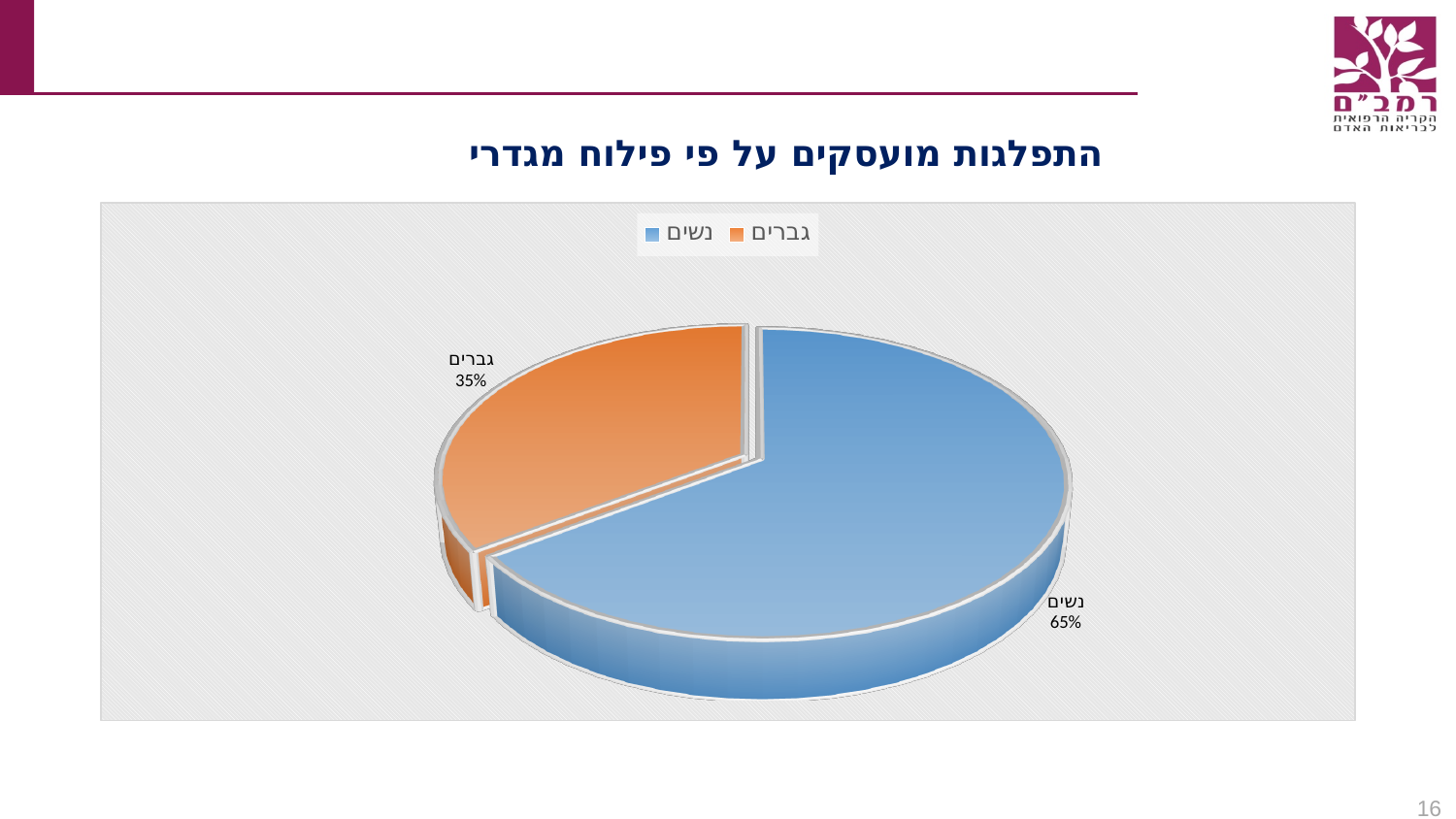
What kind of chart is shown on the slide? Pie chart What is the difference in percentage points between the נשים slice and the גברים slice? 30% What share of the pie does נשים represent? 65% What is the total of the two slices shown in the pie chart? 100% How many entries does the legend list? 2 Which slice is larger, נשים or גברים? נשים What share of the pie does גברים represent? 35% How many slices does the pie chart have? 2 Which category has the smallest slice of the pie? גברים What is the title of the chart on the slide? התפלגות מועסקים על פי פילוח מגדרי Which category has the largest slice of the pie? נשים What colour is the נשים slice of the pie? Blue